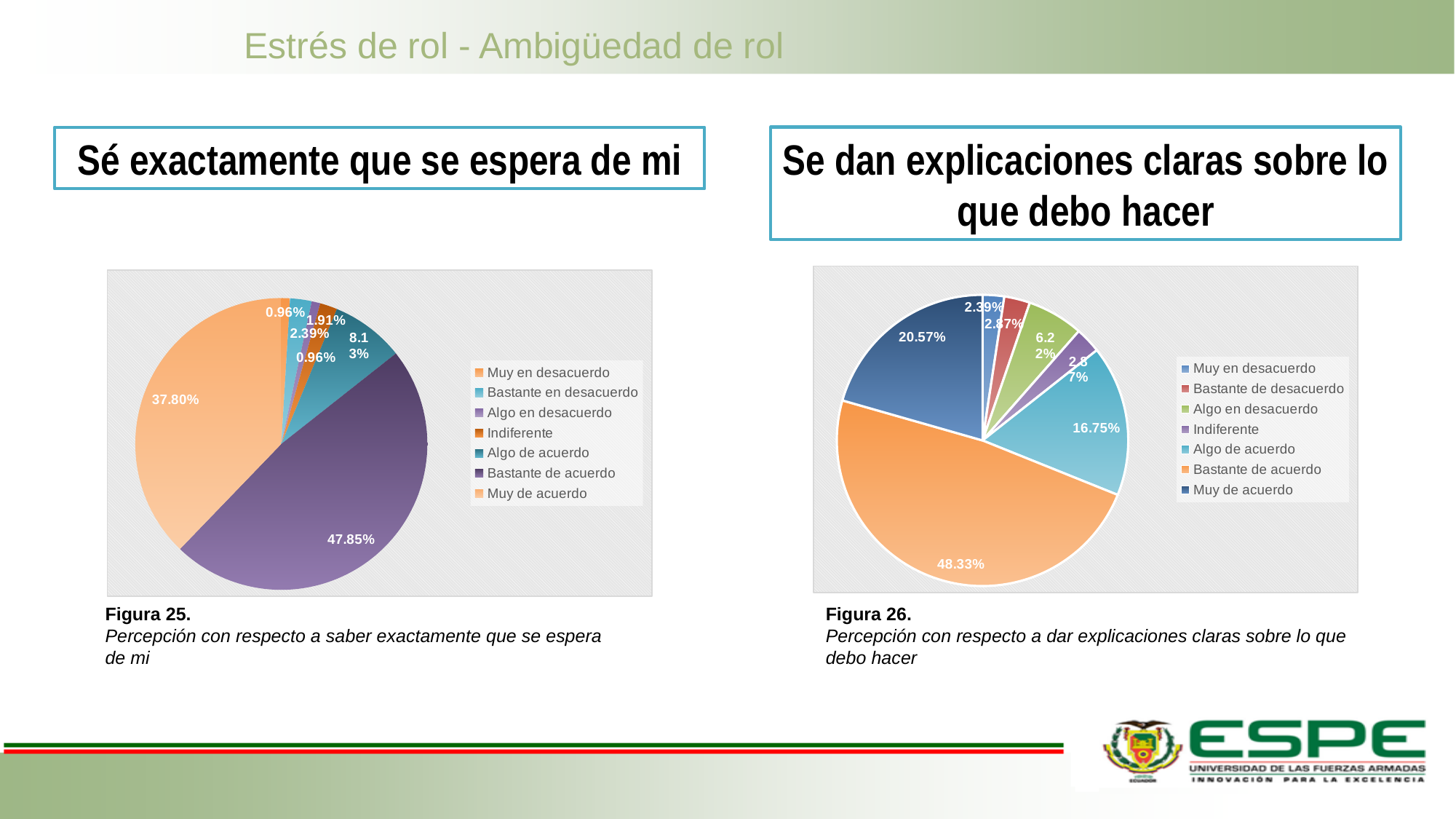
In the chart 'Sé exactamente que se espera de mi', what is the difference between 'Bastante de acuerdo' and 'Muy de acuerdo'? 10.05% In the chart 'Sé exactamente que se espera de mi', how many categories does the legend list? 7 In the chart 'Se dan explicaciones claras sobre lo que debo hacer', which category has the smallest slice? Muy en desacuerdo In the chart 'Se dan explicaciones claras sobre lo que debo hacer', what is the difference between 'Bastante de acuerdo' and 'Muy de acuerdo'? 27.76% What type of chart is used in Figura 26? Pie chart In the chart 'Sé exactamente que se espera de mi', which category has the largest slice? Bastante de acuerdo In the chart 'Se dan explicaciones claras sobre lo que debo hacer', what share does 'Muy de acuerdo' have? 20.57% In the chart 'Se dan explicaciones claras sobre lo que debo hacer', what share does 'Algo de acuerdo' have? 16.75% In the chart 'Sé exactamente que se espera de mi', what share does 'Bastante de acuerdo' have? 47.85% In the chart 'Se dan explicaciones claras sobre lo que debo hacer', which is larger, 'Muy de acuerdo' or 'Algo de acuerdo'? Muy de acuerdo In the chart 'Se dan explicaciones claras sobre lo que debo hacer', what share does 'Bastante de acuerdo' have? 48.33% In the chart 'Sé exactamente que se espera de mi', what share does 'Muy de acuerdo' have? 37.80%